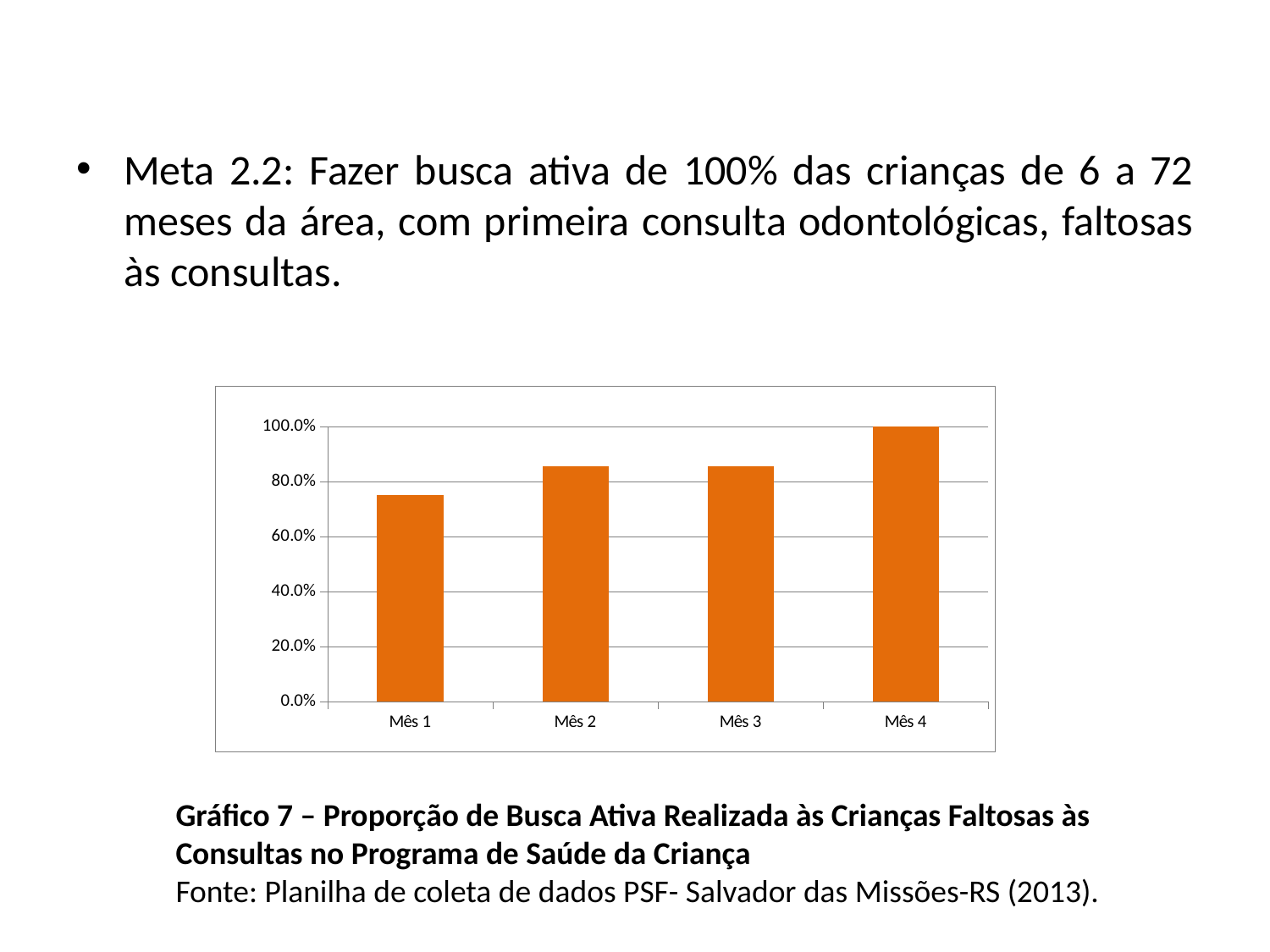
Is the value for Mês 1 greater or less than 60.0%? greater Which month has the lowest value on the chart? Mês 1 What colour are the bars in the chart? orange Which is larger, the value for Mês 1 or the value for Mês 4? Mês 4 What kind of chart is shown on the slide? bar chart Which month has the highest value on the chart? Mês 4 What is the value for Mês 4? 100.0% Is the value for Mês 1 greater or less than 80.0%? less Do the values generally rise or fall from Mês 1 to Mês 4? rise Is the value for Mês 2 greater or less than 80.0%? greater How many months (categories) are plotted on the chart? 4